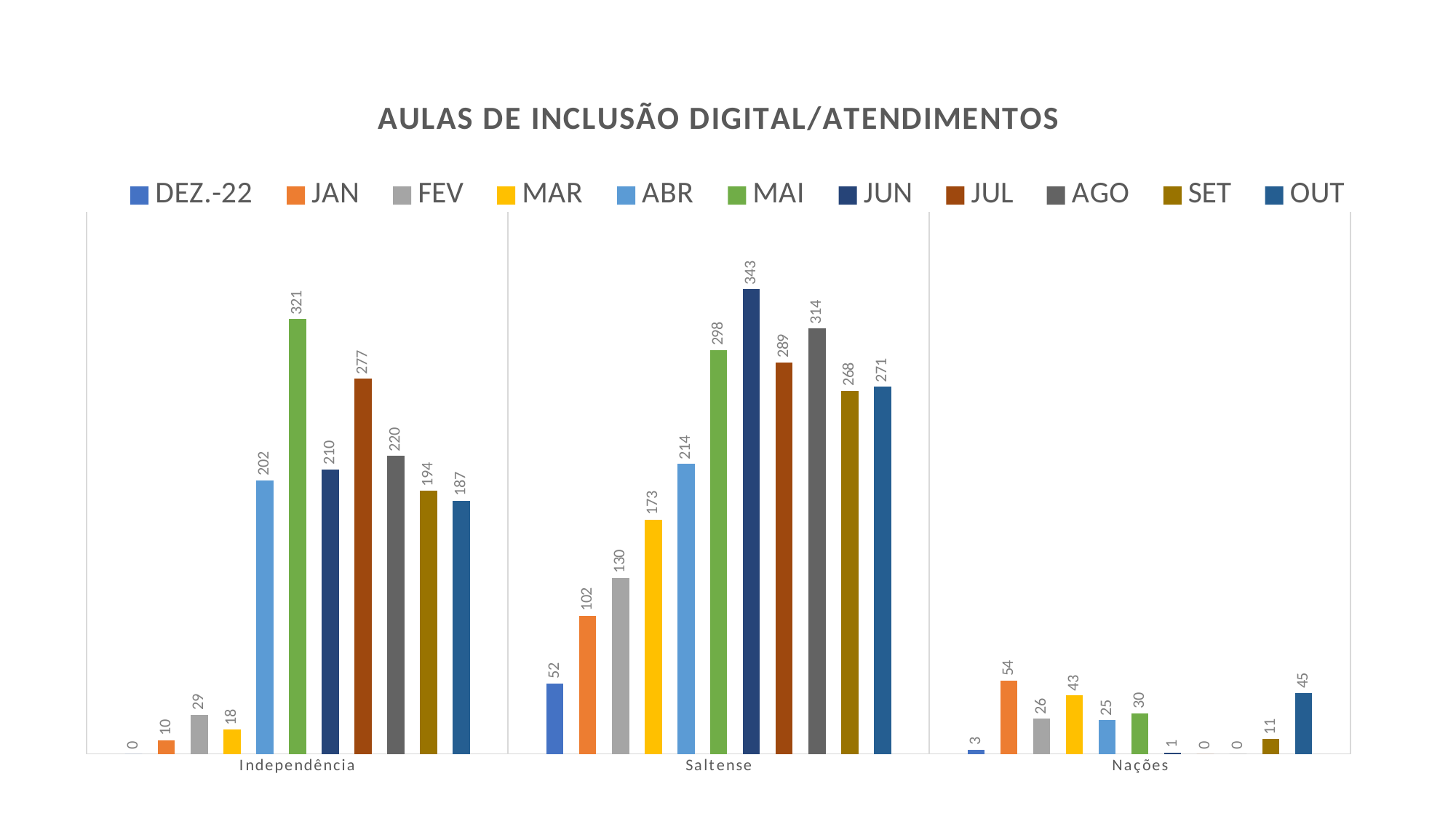
What kind of chart is shown on the slide? Bar chart Which month has the highest value in the Independência category? MAI What is the value for MAI in the Independência category? 321 Which month has the highest value in the Saltense category? JUN What is the value for JUN in the Saltense category? 343 What is the difference between the AGO and SET values in the Saltense category? 46 What is the title of the chart? AULAS DE INCLUSÃO DIGITAL/ATENDIMENTOS How many series does the legend list? 11 What is the difference between the MAI value for Independência and the MAI value for Saltense? 23 What is the value for OUT in the Nações category? 45 How many categories are shown on the x axis? 3 Which is larger in the Nações category, the JAN value or the OUT value? JAN